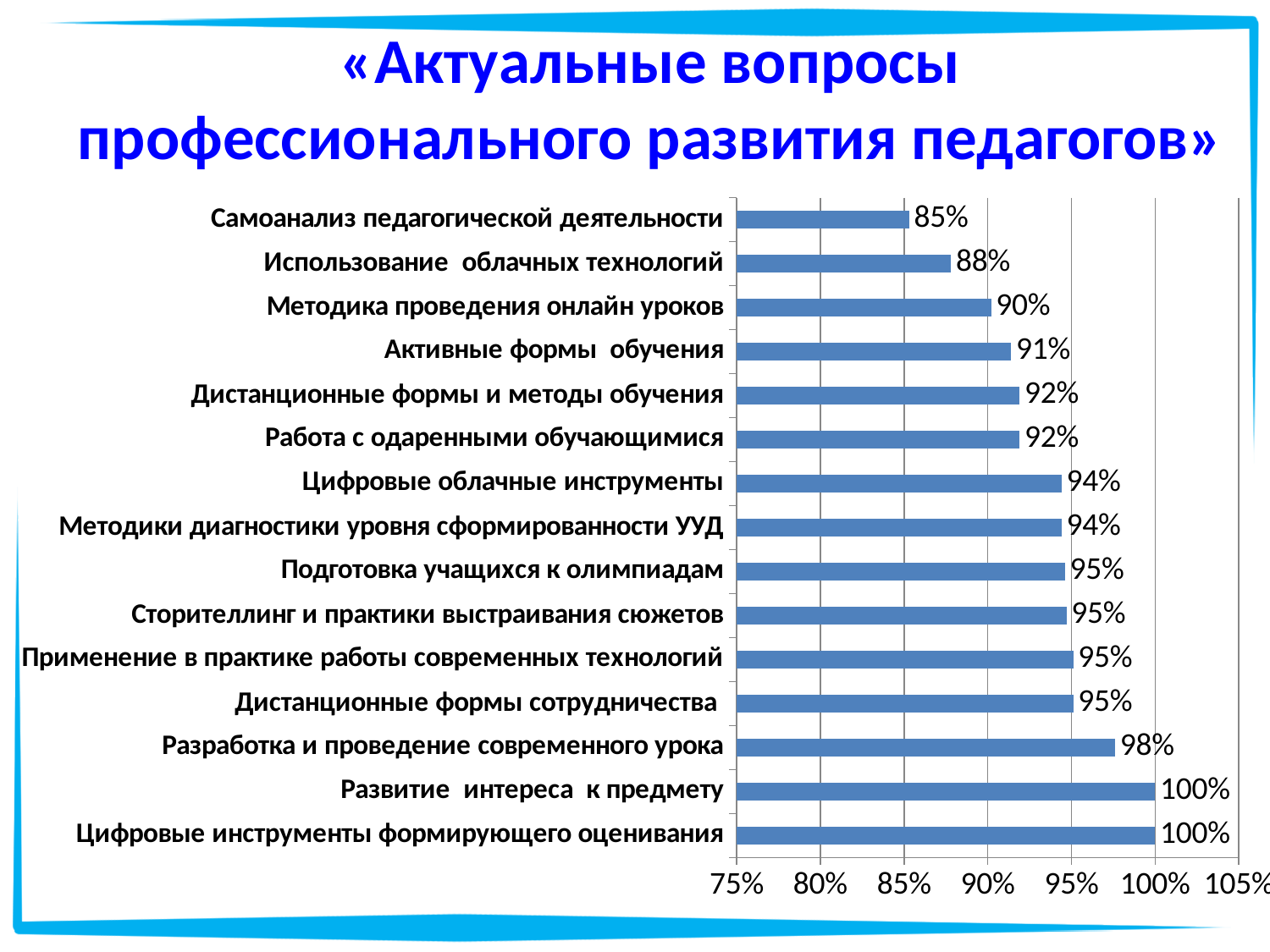
Which two categories share the highest value of 100%? Развитие интереса к предмету; Цифровые инструменты формирующего оценивания What is the value for «Разработка и проведение современного урока»? 98% What kind of chart is shown on the slide? Bar chart What is the difference between the value for «Развитие интереса к предмету» and the value for «Самоанализ педагогической деятельности»? 15 percentage points What is the title of the slide? «Актуальные вопросы профессионального развития педагогов» Which category has the lowest value? Самоанализ педагогической деятельности How many categories are shown in the chart? 15 Is the value for «Самоанализ педагогической деятельности» greater or less than 90%? less Which is larger: the value for «Разработка и проведение современного урока» or the value for «Методика проведения онлайн уроков»? Разработка и проведение современного урока What is the value for «Самоанализ педагогической деятельности»? 85% What is the value for «Активные формы обучения»? 91% What is the value for «Использование облачных технологий»? 88%